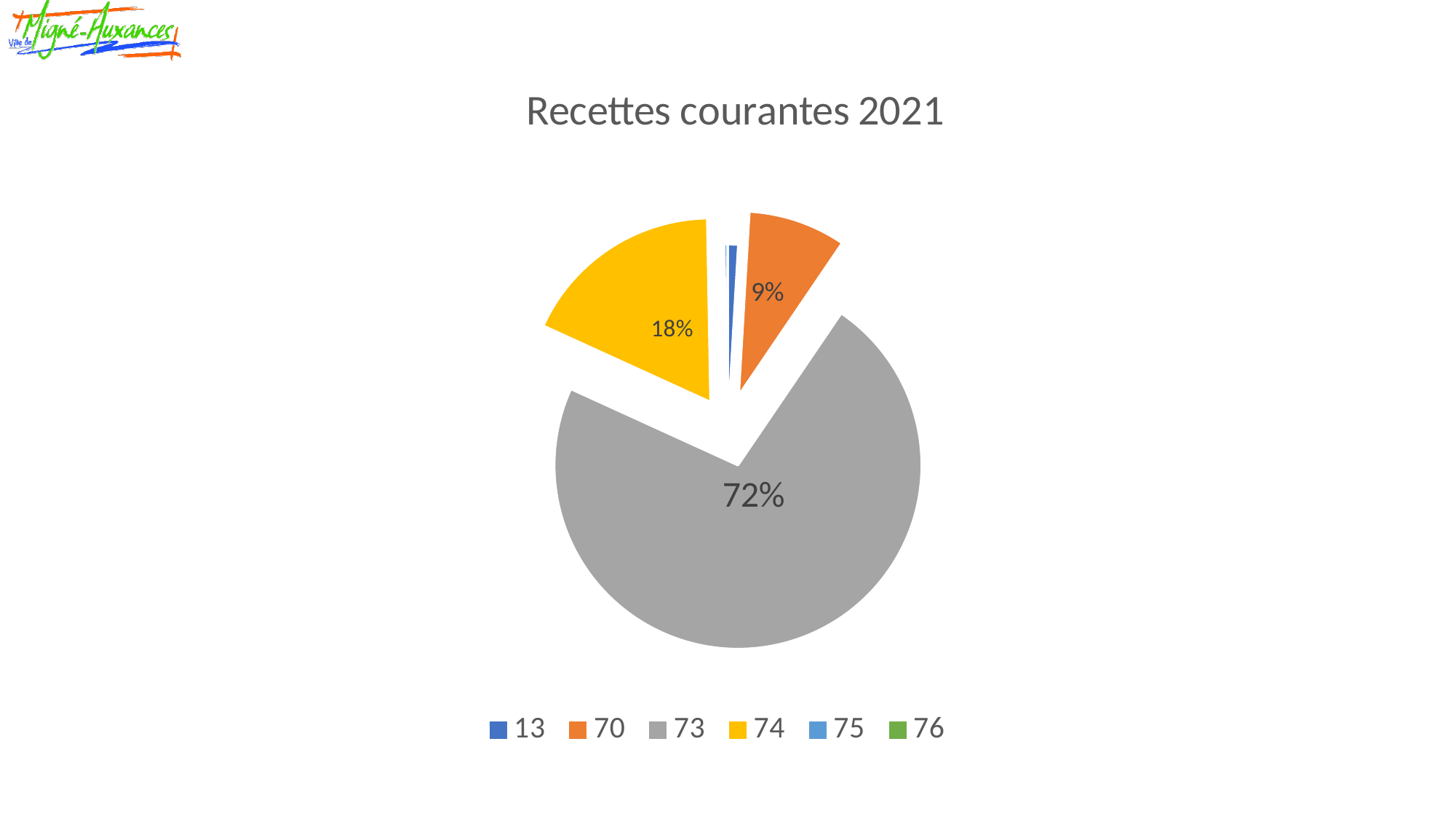
Which category has the largest slice of the pie? 73 How many percentage points larger is the share of category 73 than that of category 74? 54 Is the share of category 73 greater or less than 50%? greater Which has the larger share, category 74 or category 70? 74 What percentage share does category 73 have in the pie chart? 72% How many entries does the legend list? 6 What is the title of the chart? Recettes courantes 2021 How many percentage points larger is the share of category 74 than that of category 70? 9 What percentage share does category 70 have in the pie chart? 9% What type of chart is shown on the slide? pie chart What colour is the slice for category 73? grey What percentage share does category 74 have in the pie chart? 18%